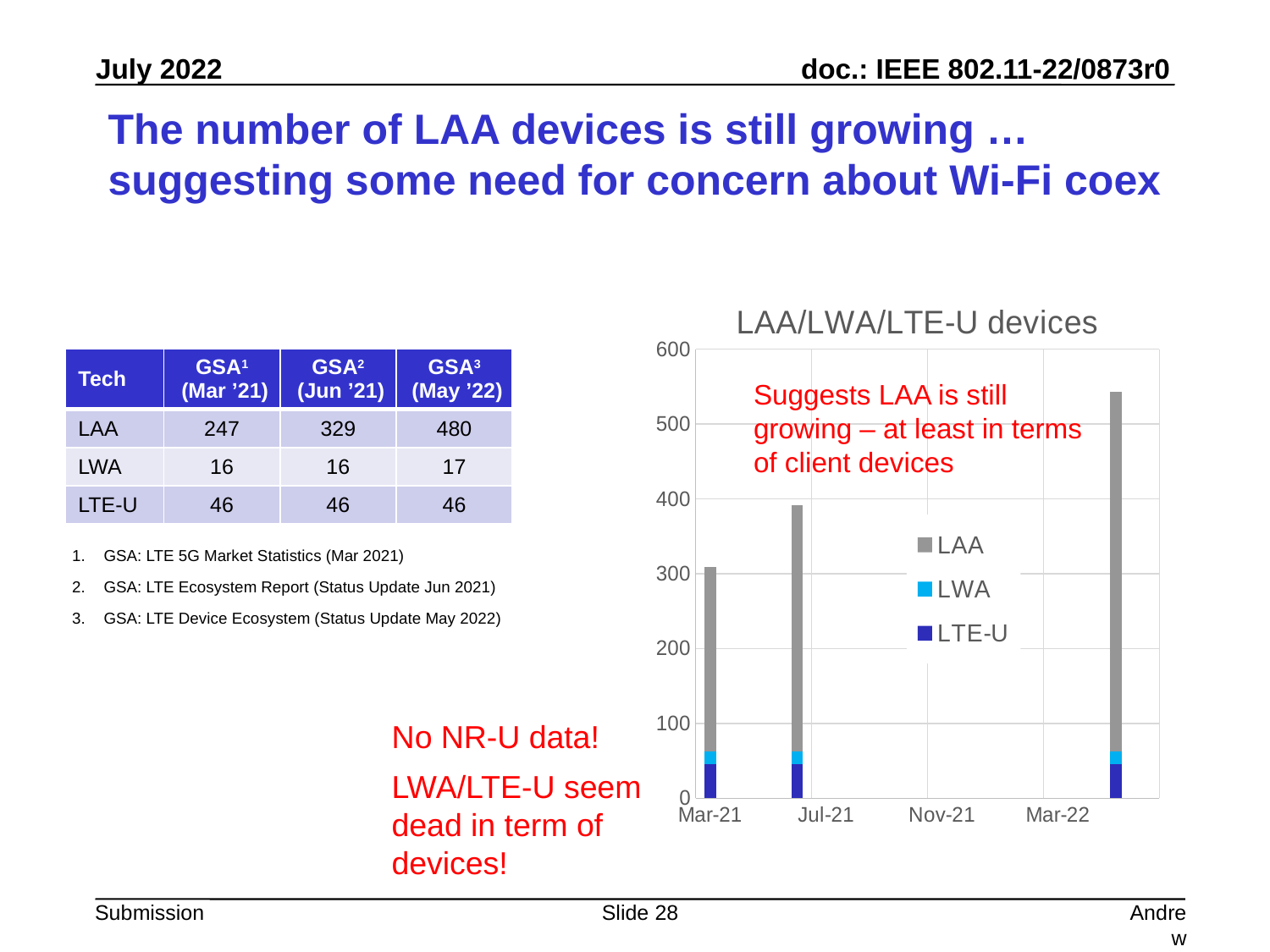
How many series does the chart's legend list? 3 Do the total bar heights rise or fall from left to right along the x axis? rise What is the title of the chart? LAA/LWA/LTE-U devices Is the LTE-U segment of the Mar-21 bar greater or less than 100? less Which bar in the chart is the tallest? the rightmost bar (after Mar-22) Which bar in the chart is the shortest? the leftmost bar (Mar-21) What type of chart is shown on the slide? bar chart Is the total height of the Mar-21 bar greater or less than 200? greater Which series are listed in the chart's legend? LAA, LWA, LTE-U How many stacked bars are plotted in the chart? 3 Which series makes up the largest segment of each stacked bar? LAA Is the total height of the rightmost bar greater or less than 500? greater